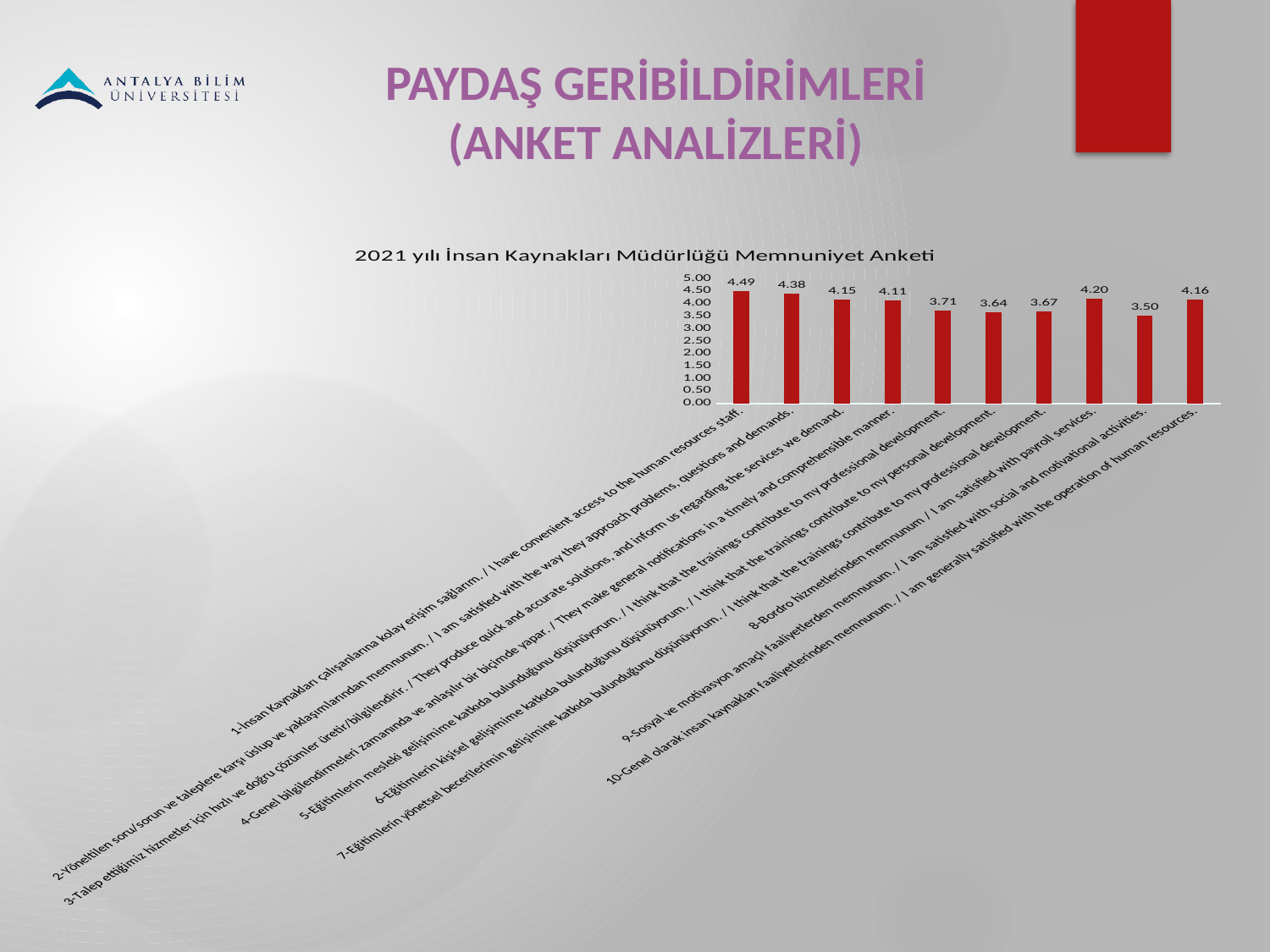
What is the maximum value shown on the vertical axis? 5.00 Which item has the highest value in the chart? 1 (easy access to the human resources staff), 4.49 What is the value for item 8 (satisfied with payroll services)? 4.20 What is the value for item 10 (generally satisfied with the operation of human resources)? 4.16 What kind of chart is shown on the slide? bar chart Which is larger: the value for item 2 (the way they approach problems) or item 5 (trainings contribute to professional development)? item 2 (4.38) Which item has the lowest value in the chart? 9 (social and motivational activities), 3.50 How many categories (survey items) are plotted in the chart? 10 What is the title of the chart? 2021 yılı İnsan Kaynakları Müdürlüğü Memnuniyet Anketi What is the difference between the values for item 1 (4.49) and item 9 (3.50)? 0.99 Is the value for item 6 (trainings contribute to personal development) greater or less than 4.00? less What is the value for item 1 (easy access to the human resources staff)? 4.49